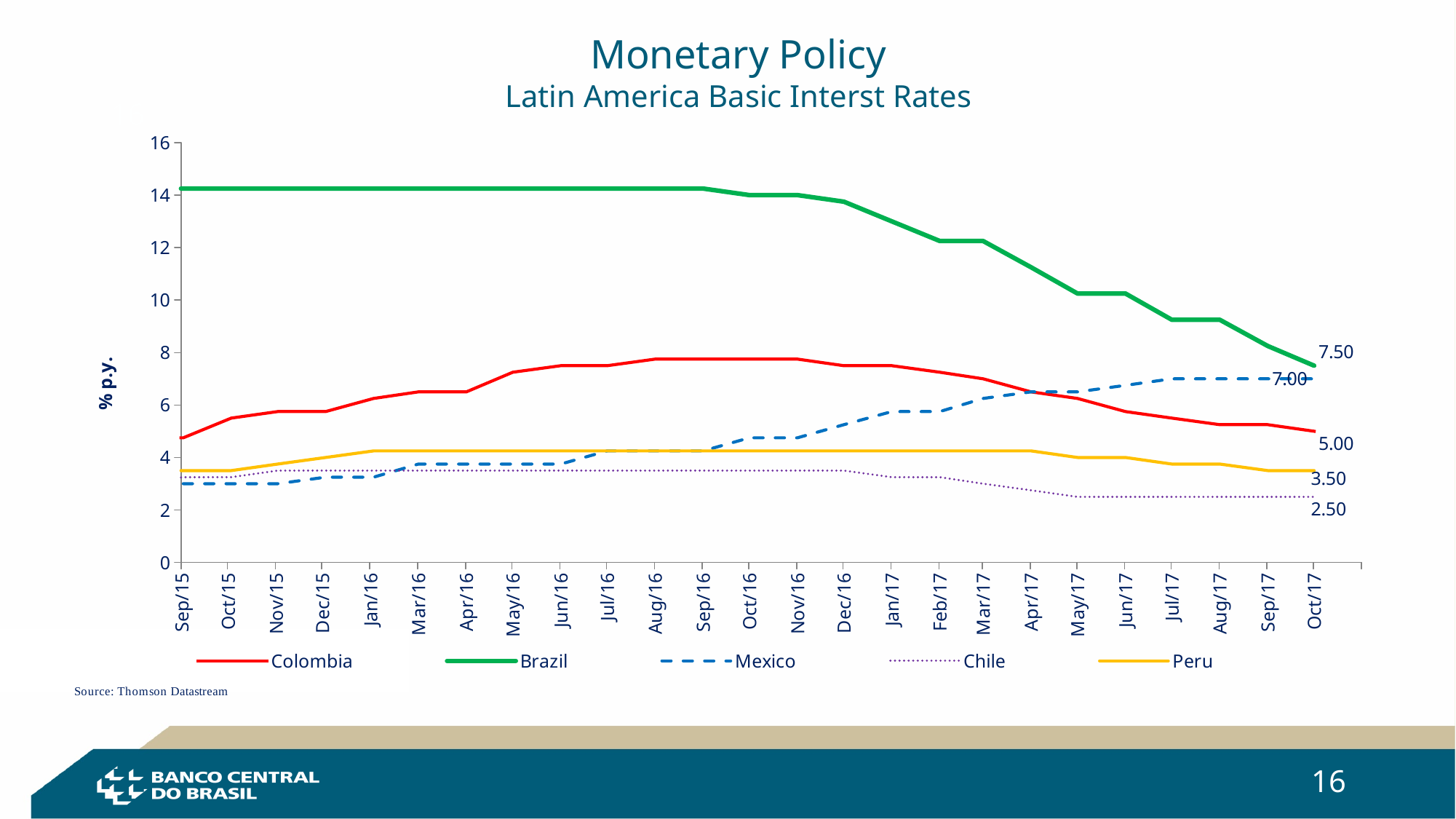
Is the value for Colombia at Sep/15 greater or less than 6? less What kind of chart is shown on the slide? line chart What is the value for Colombia at Oct/17? 5.00 Does the Brazil line rise or fall from Sep/15 to Oct/17? fall What is the value for Peru at Oct/17? 3.50 Which country has the highest rate at Oct/17? Brazil How many series does the legend list? 5 What is the value for Chile at Oct/17? 2.50 What is the value for Mexico at Oct/17? 7.00 Which country has the lowest rate at Oct/17? Chile What is the difference between the Brazil and Mexico values at Oct/17? 0.50 What is the value for Brazil at Oct/17? 7.50